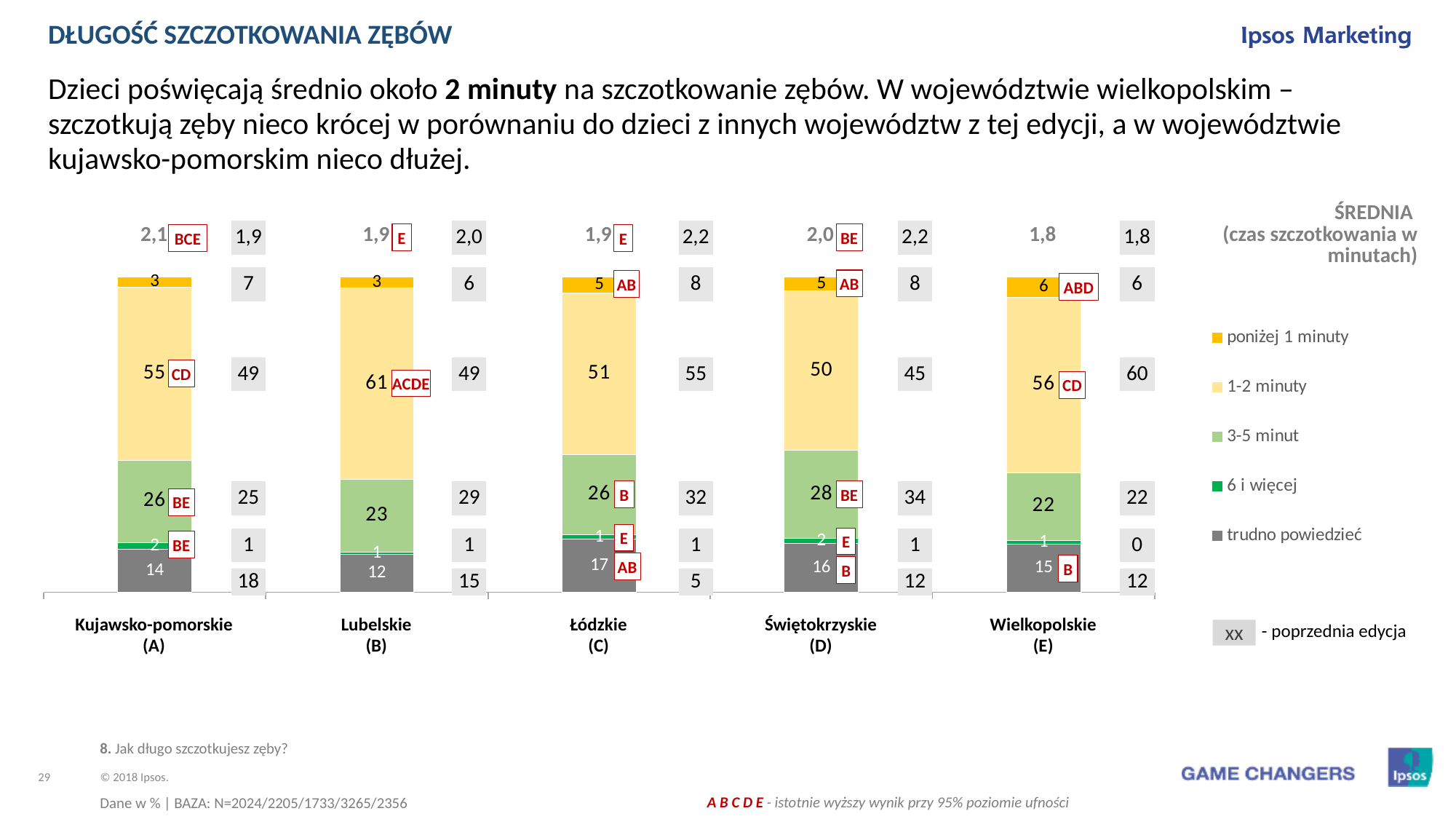
What type of chart is shown on the slide? stacked bar chart Which voivodeship has the lowest average brushing time (ŚREDNIA) in the current edition? Wielkopolskie (E) How many series does the chart legend list? 5 What colour represents the '1-2 minuty' series in the chart? light yellow What is the difference between the '3-5 minut' values for Świętokrzyskie (D) and Wielkopolskie (E)? 6 What is the average brushing time (ŚREDNIA) shown above the bar for Kujawsko-pomorskie (A)? 2,1 Which voivodeship has the highest value for the '1-2 minuty' segment? Lubelskie (B) How many voivodeships (categories) are shown on the x axis of the chart? 5 What is the value of the '1-2 minuty' segment for Lubelskie (B)? 61 Which is larger: the 'poniżej 1 minuty' value for Wielkopolskie (E) or for Kujawsko-pomorskie (A)? Wielkopolskie (E) What is the total of the stacked bar for Kujawsko-pomorskie (A)? 100 What is the value of the 'trudno powiedzieć' segment for Łódzkie (C)? 17